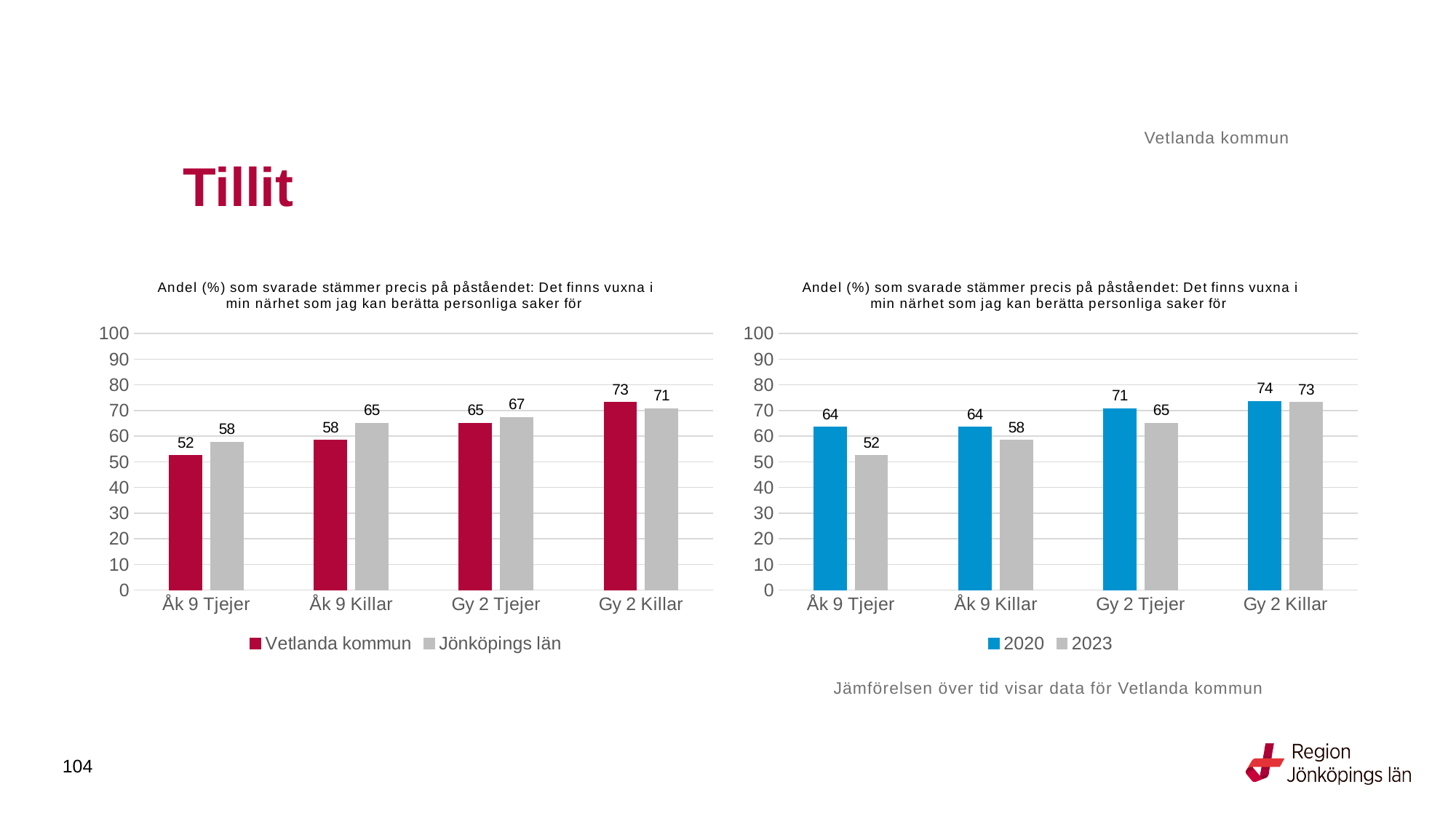
In the right chart, what is the 2023 value for Åk 9 Tjejer? 52 What kind of chart is the left chart? Bar chart In the right chart, which category has the highest 2020 value? Gy 2 Killar How many series does the legend of the right chart list? 2 In the left chart, which is larger for Gy 2 Killar: Vetlanda kommun or Jönköpings län? Vetlanda kommun In the left chart, what is the value for Vetlanda kommun for Åk 9 Tjejer? 52 In the right chart, what is the difference between the 2020 and 2023 values for Åk 9 Tjejer? 12 In the left chart, what is the value for Jönköpings län for Gy 2 Tjejer? 67 In the left chart, what is the difference between Jönköpings län and Vetlanda kommun for Åk 9 Killar? 7 In the right chart, what is the 2020 value for Gy 2 Tjejer? 71 In the left chart, which category has the lowest value for Jönköpings län? Åk 9 Tjejer In the left chart, which category has the highest value for Vetlanda kommun? Gy 2 Killar